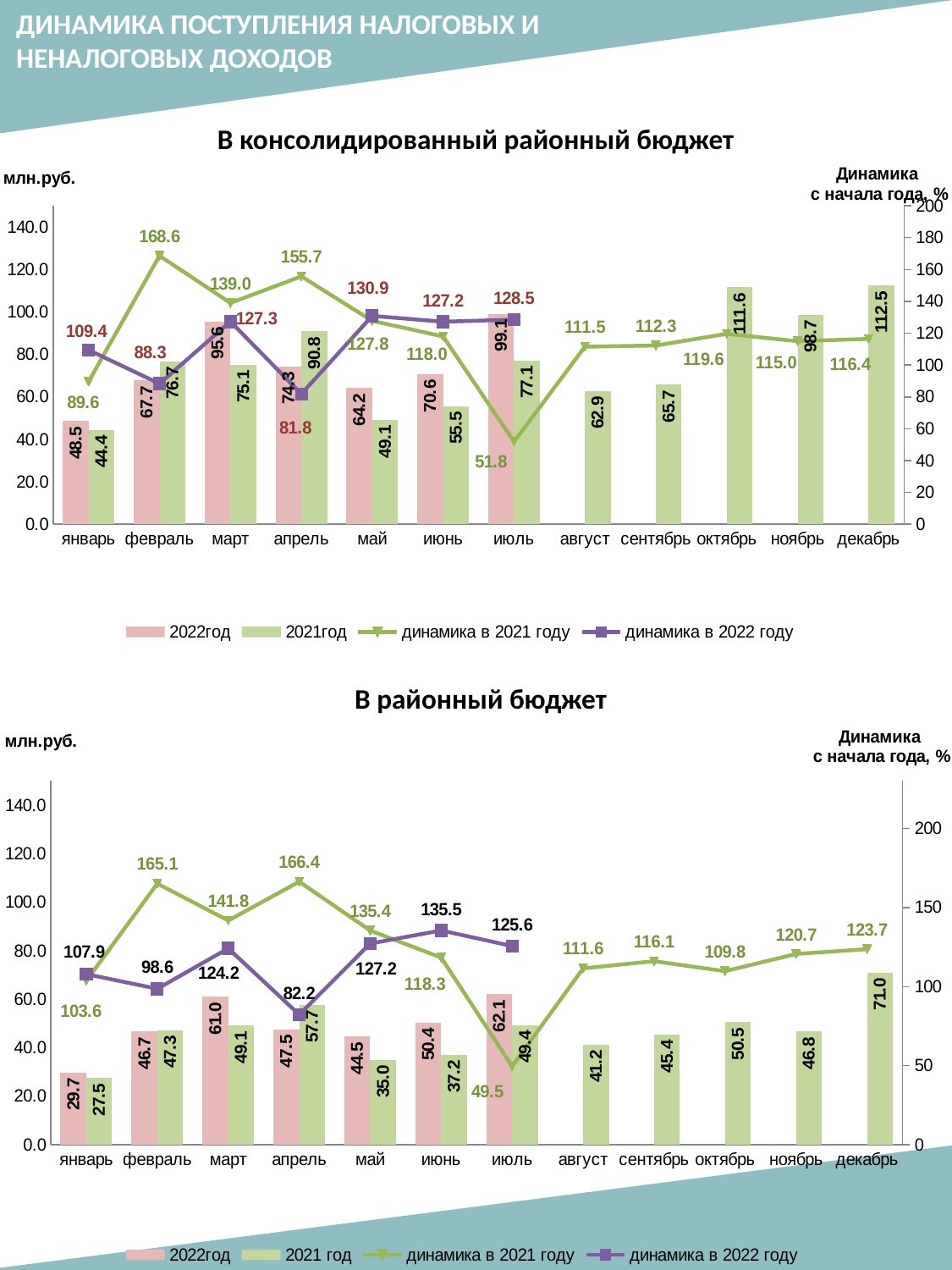
In the chart 'В районный бюджет', what is the value of the 2022год bar for июль? 62.1 In the chart 'В консолидированный районный бюджет', which month has the lowest value of 'динамика в 2021 году'? июль In the chart 'В консолидированный районный бюджет', what is the value of the 2022год bar for март? 95.6 In the chart 'В консолидированный районный бюджет', what is the value of the 2021год bar for октябрь? 111.6 In the chart 'В консолидированный районный бюджет', what is the value of 'динамика в 2021 году' for февраль? 168.6 In the chart 'В районный бюджет', what is the value of 'динамика в 2022 году' for июнь? 135.5 In the chart 'В консолидированный районный бюджет', how many series does the legend list? 4 What type of chart is 'В районный бюджет'? Combined bar and line chart In the chart 'В районный бюджет', how many months are shown on the x axis? 12 In the chart 'В районный бюджет', which is larger for май: the 2022год bar or the 2021 год bar? 2022год In the chart 'В консолидированный районный бюджет', what is the difference between the 2022год and 2021год bars for июль? 22.0 In the chart 'В районный бюджет', which month has the highest 2021 год bar? декабрь